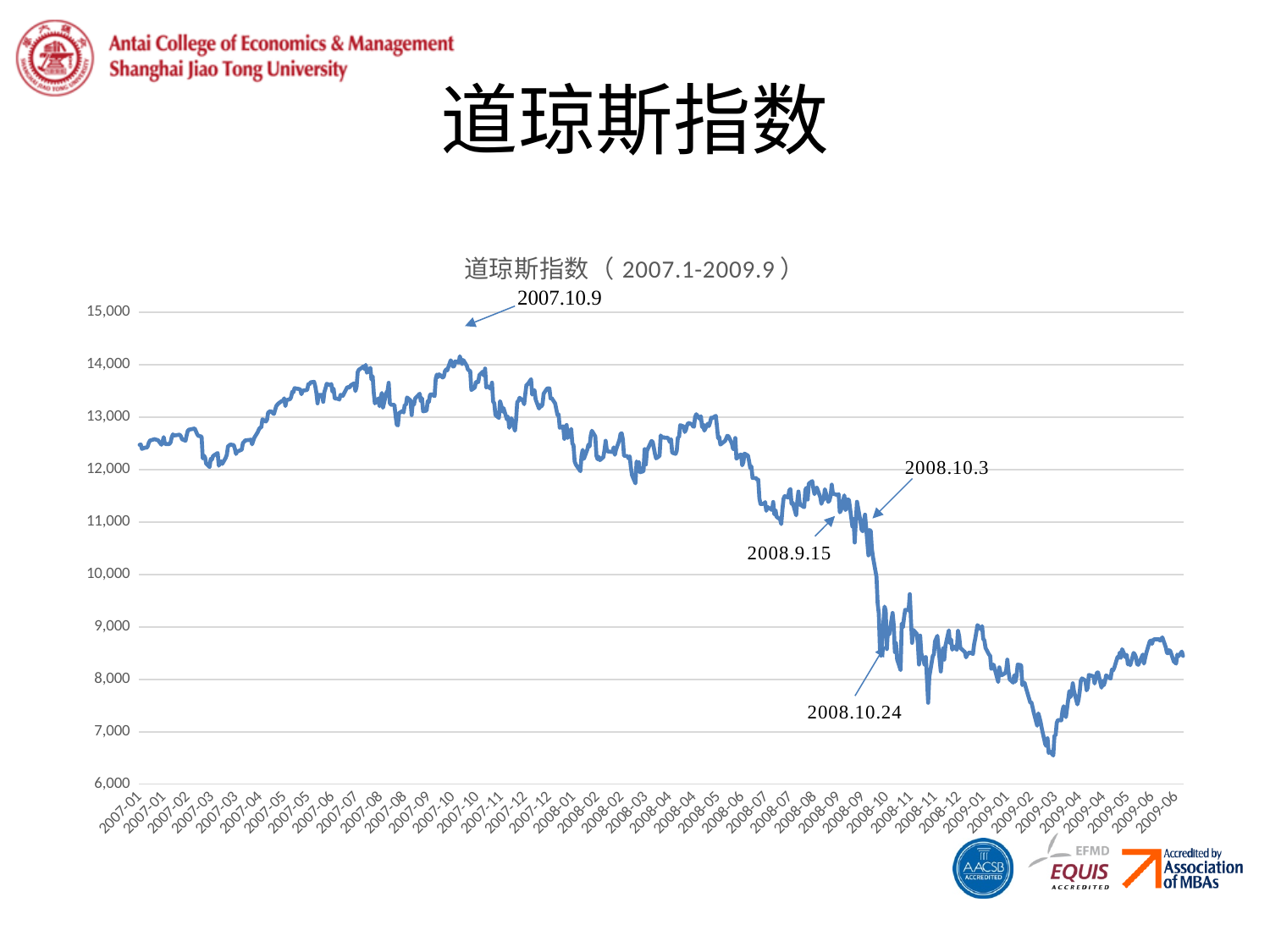
Which is higher, the index at 2007-01 or the index at 2009-06? 2007-01 Is the value of the index at the start of the series (2007-01) greater or less than 12,000? greater Is the value of the index around 2007-10 greater or less than 13,000? greater Is the value of the index at the point annotated 2008.10.24 greater or less than 10,000? less Which date is annotated at the peak of the line near 2007-10? 2007.10.9 What kind of chart is shown on the slide? line chart Which is higher, the index around 2007-10 or the index around 2009-03? 2007-10 What is the title of the chart? 道琼斯指数（2007.1-2009.9） Does the index rise or fall between 2007-10 and 2009-03? fall Does the index rise or fall between 2009-03 and 2009-06? rise